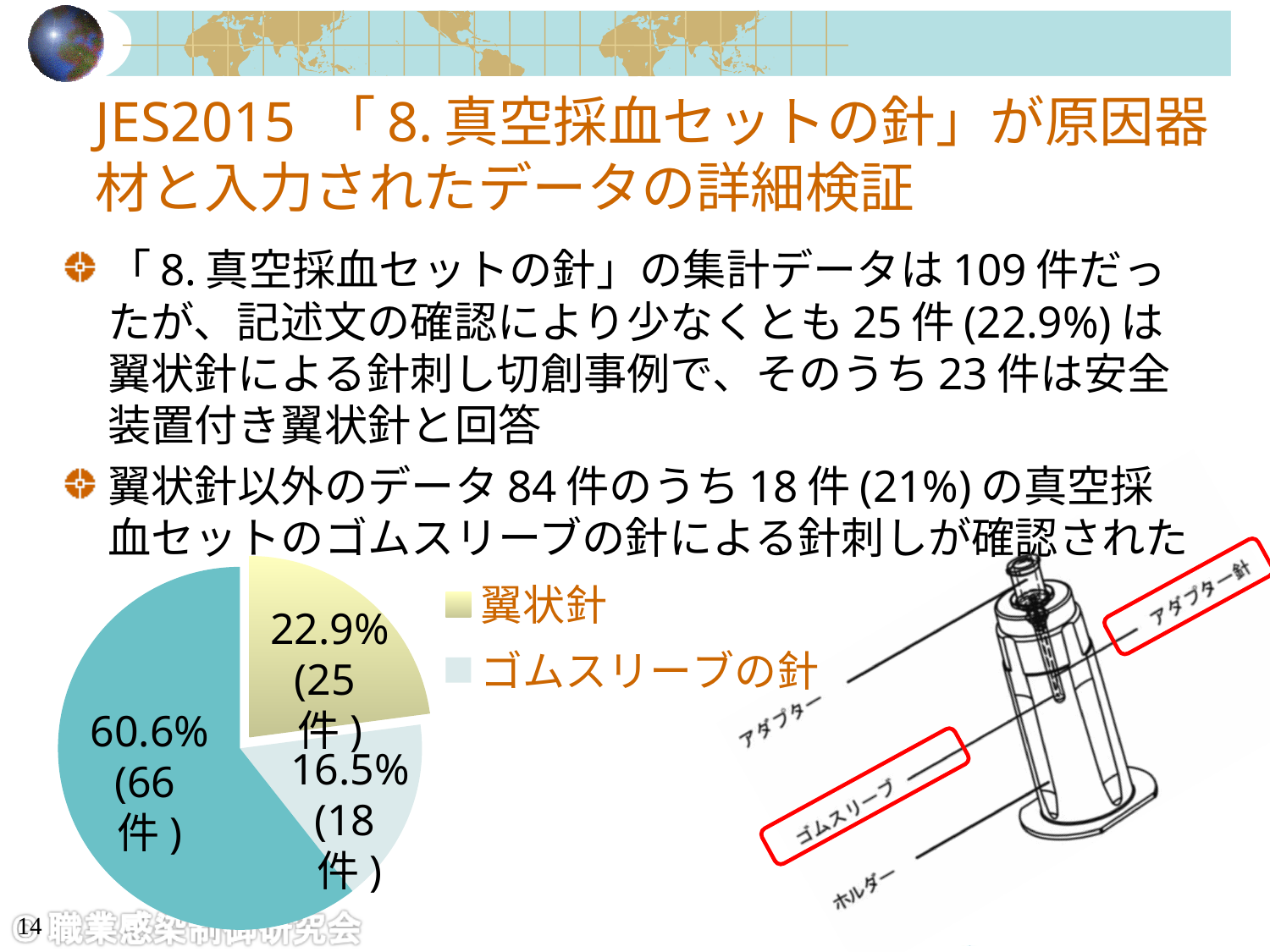
Which slice is smaller, 翼状針 or ゴムスリーブの針? ゴムスリーブの針 Which is larger, the 翼状針 slice or the ゴムスリーブの針 slice? 翼状針 What is the percentage shown on the largest slice of the pie? 60.6% How many slices does the pie chart have? 3 What is the difference in cases between the 翼状針 slice (25件) and the ゴムスリーブの針 slice (18件)? 7件 How many cases (件) does the largest slice of the pie represent? 66件 How many cases (件) does the 翼状針 slice represent? 25件 How many entries are listed in the chart legend? 2 What kind of chart is shown on the slide? pie chart How many cases (件) does the ゴムスリーブの針 slice represent? 18件 What percentage of the pie does 翼状針 account for? 22.9% What percentage of the pie does ゴムスリーブの針 account for? 16.5%